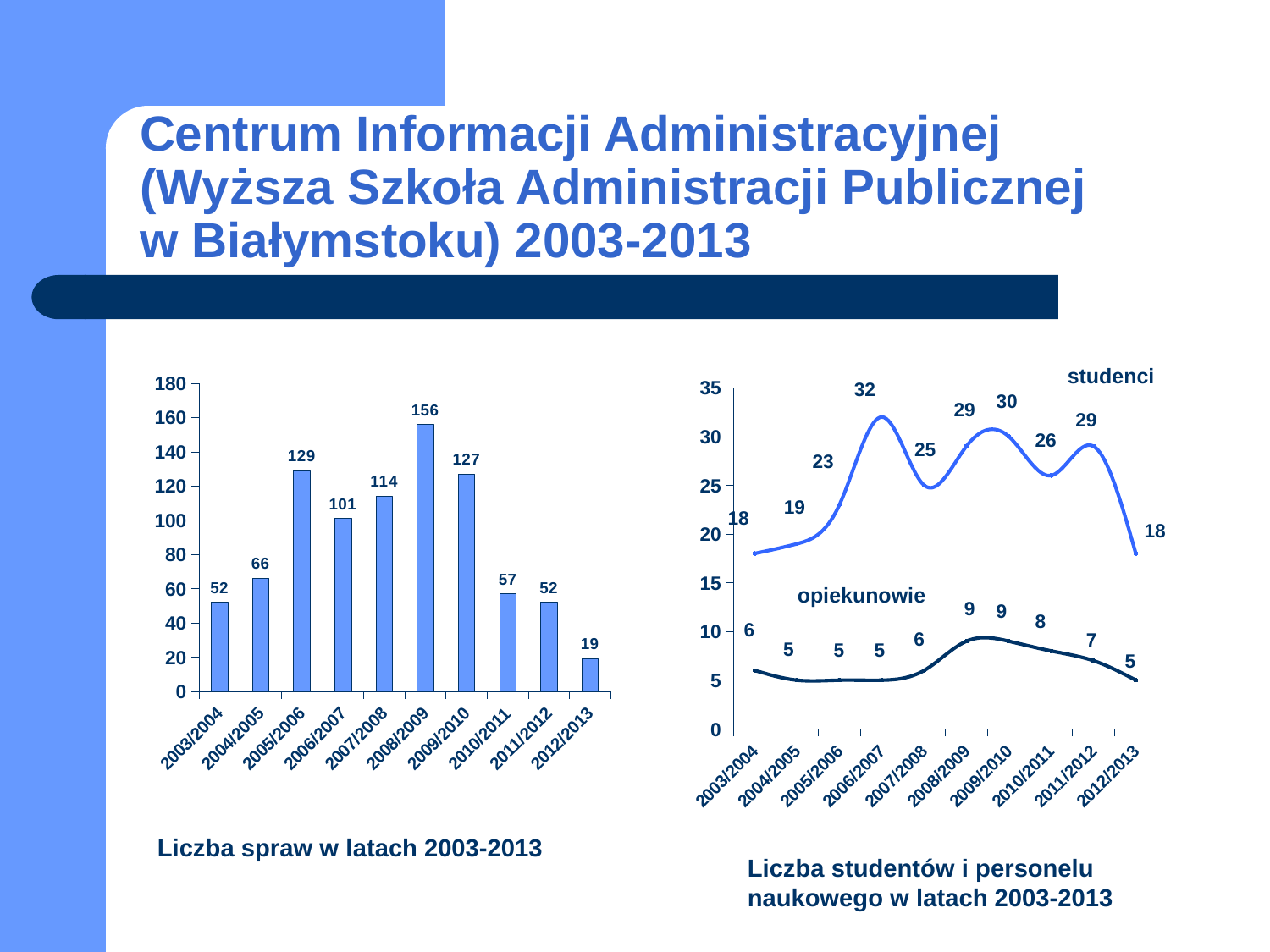
In the chart 'Liczba spraw w latach 2003-2013', what is the difference between the values for 2005/2006 and 2006/2007? 28 In the chart 'Liczba studentów i personelu naukowego w latach 2003-2013', what is the value for opiekunowie in 2010/2011? 8 In the chart 'Liczba studentów i personelu naukowego w latach 2003-2013', which year has the highest value for studenci? 2006/2007 In the chart 'Liczba spraw w latach 2003-2013', what is the value for 2008/2009? 156 What kind of chart is 'Liczba studentów i personelu naukowego w latach 2003-2013'? line chart In the chart 'Liczba spraw w latach 2003-2013', which year has the lowest value? 2012/2013 What kind of chart is 'Liczba spraw w latach 2003-2013'? bar chart In the chart 'Liczba studentów i personelu naukowego w latach 2003-2013', is the value for studenci in 2011/2012 larger than in 2010/2011? Yes In the chart 'Liczba studentów i personelu naukowego w latach 2003-2013', what is the value for studenci in 2006/2007? 32 In the chart 'Liczba studentów i personelu naukowego w latach 2003-2013', what is the difference between studenci and opiekunowie in 2009/2010? 21 In the chart 'Liczba spraw w latach 2003-2013', which year has the highest value? 2008/2009 In the chart 'Liczba spraw w latach 2003-2013', how many years are shown on the x axis? 10